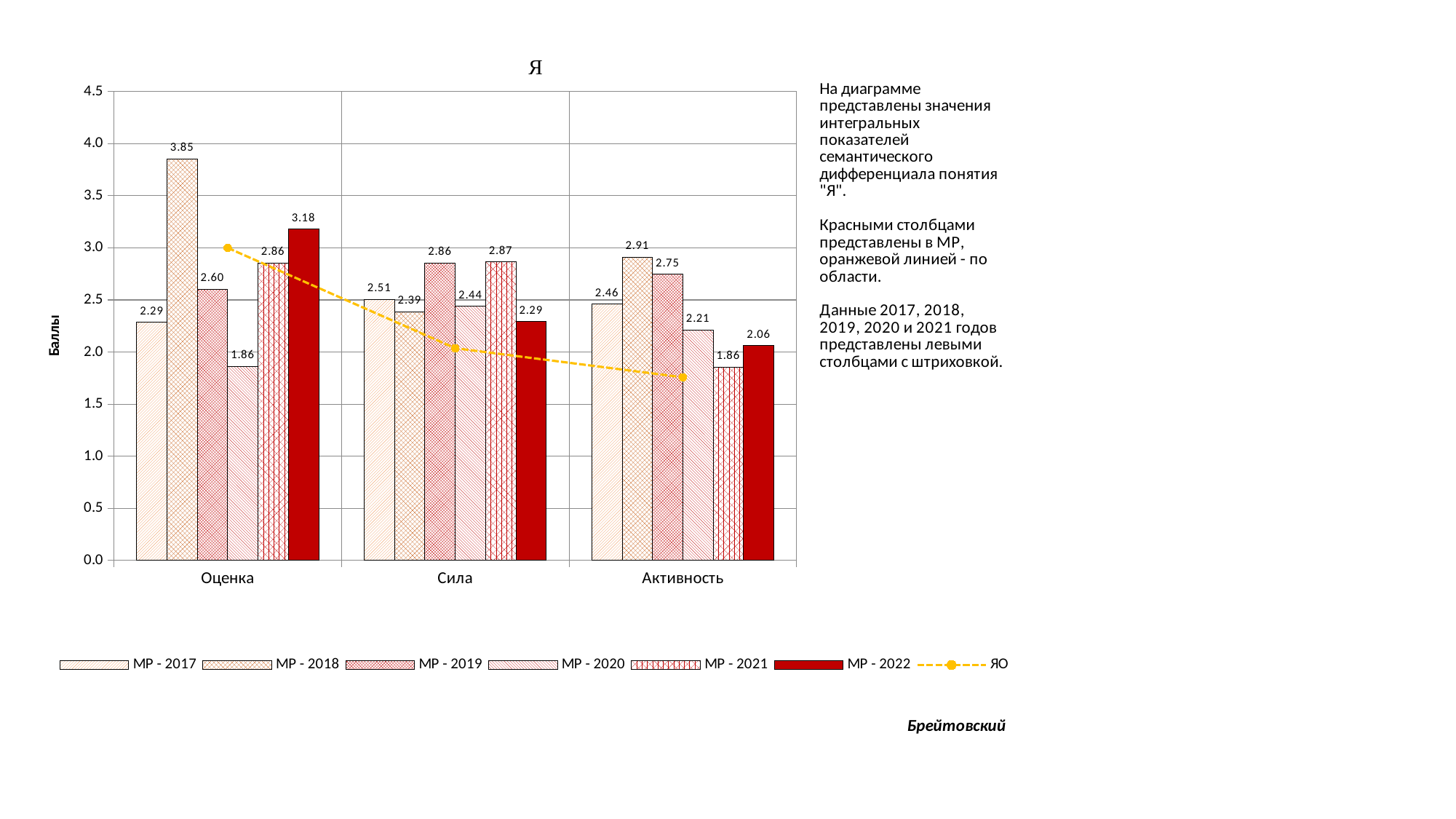
How many series does the legend list? 7 Which series has the lowest value in the Оценка category? МР - 2020 What kind of chart is this? Bar chart with a line Is the ЯО value for Активность greater or less than 2.0? less Which category has the highest value for МР - 2022? Оценка What is the difference between the МР - 2022 values for Оценка and Сила? 0.89 Which is larger: МР - 2019 for Сила or МР - 2019 for Активность? МР - 2019 for Сила How many categories are shown on the x axis? 3 What is the value of МР - 2021 for Сила? 2.87 What is the value of МР - 2022 for Активность? 2.06 What is the value of МР - 2018 for Оценка? 3.85 Does the ЯО line rise or fall from Оценка to Активность? fall